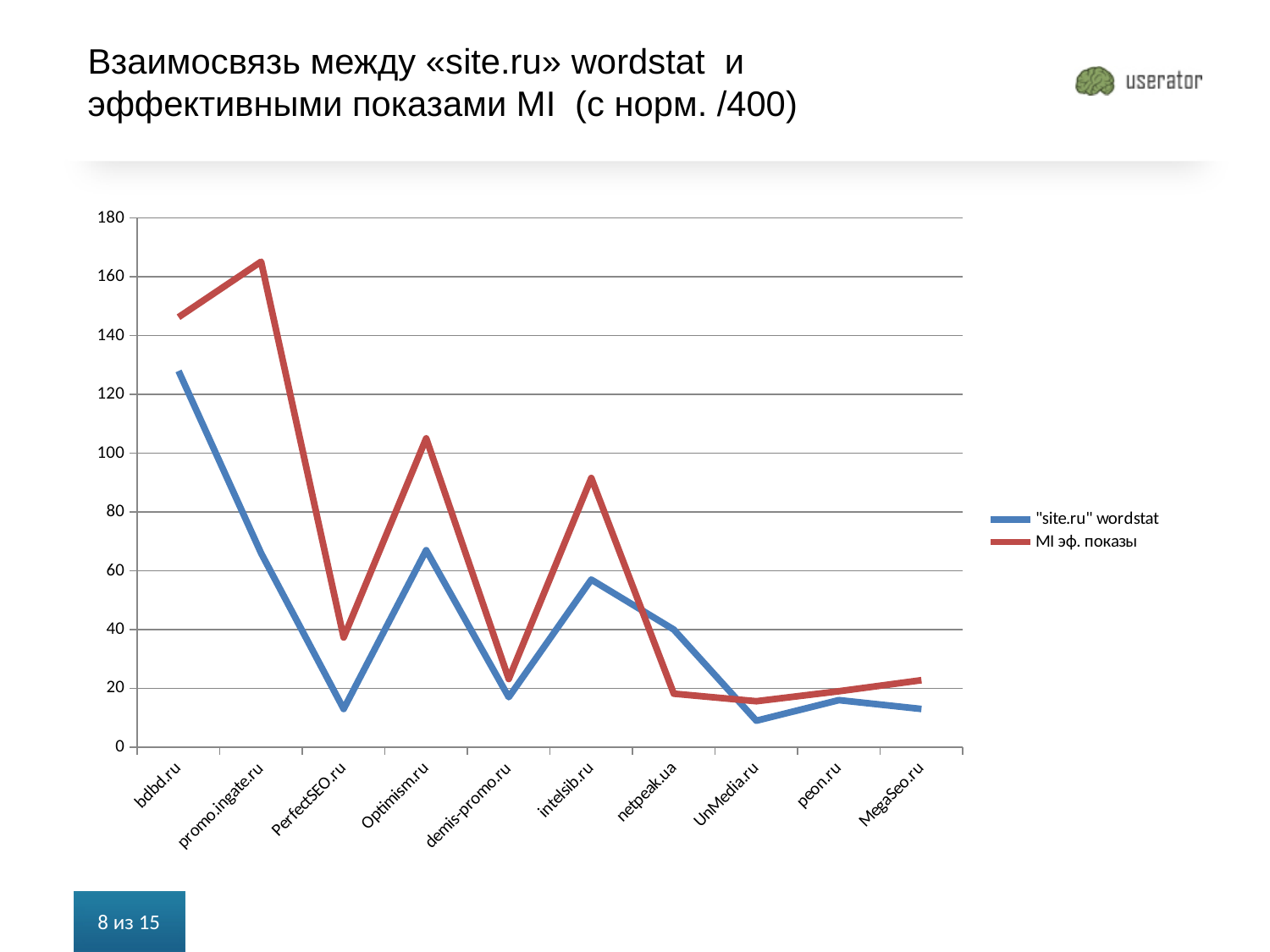
Which category has the lowest value for the "site.ru" wordstat series? UnMedia.ru Is the "MI эф. показы" value for Optimism.ru greater or less than 100? greater Which colour is used for the "MI эф. показы" line? red At netpeak.ua, which series has the larger value: "site.ru" wordstat or "MI эф. показы"? "site.ru" wordstat What kind of chart is shown on the slide? line chart How many categories are plotted along the x axis? 10 How many series does the legend list? 2 Is the "MI эф. показы" value for bdbd.ru greater or less than 140? greater Which category has the highest value for the "MI эф. показы" series? promo.ingate.ru Is the "site.ru" wordstat value for PerfectSEO.ru greater or less than 20? less Which category has the highest value for the "site.ru" wordstat series? bdbd.ru